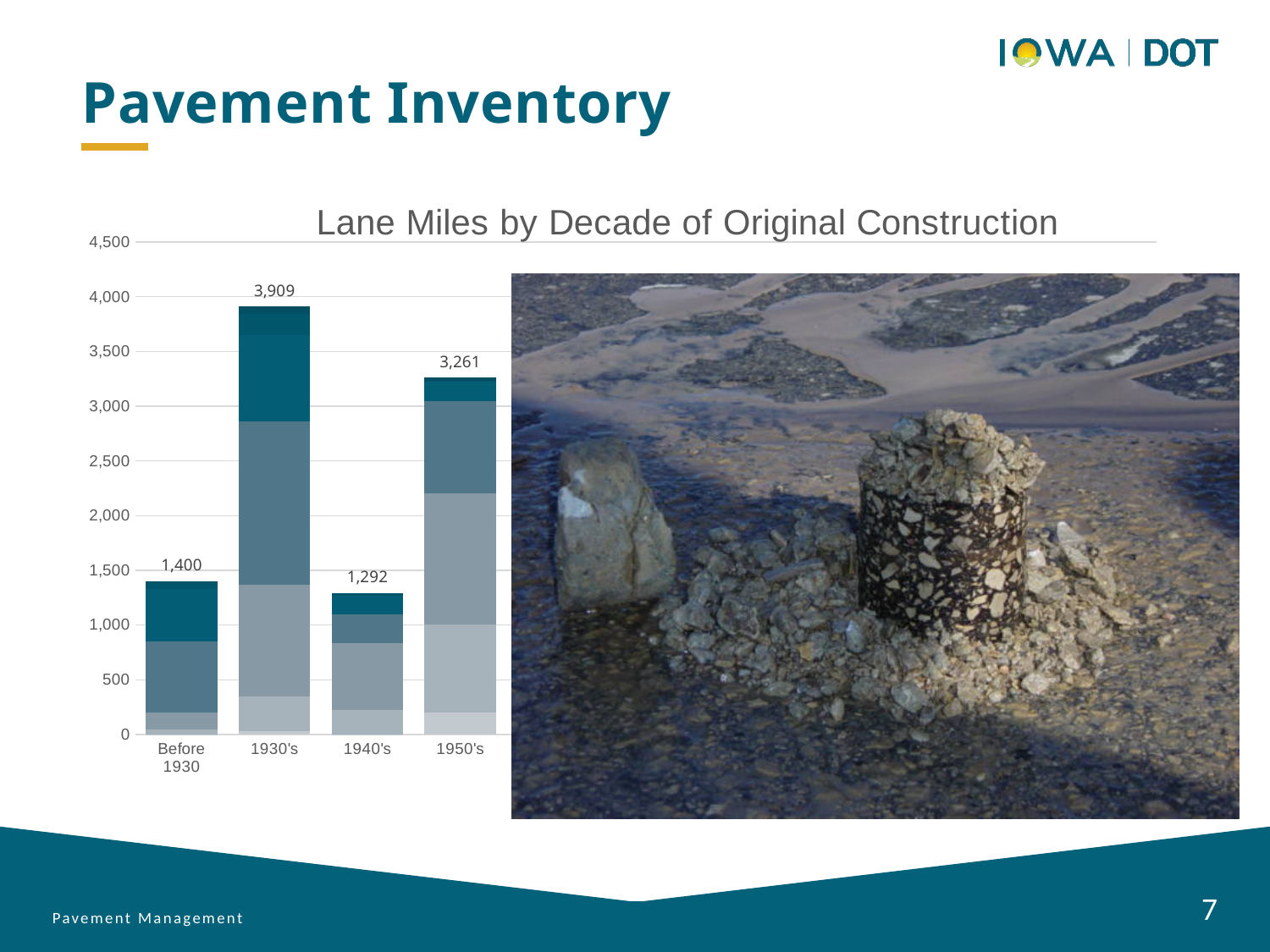
What kind of chart is shown on the slide? Stacked bar chart What is the title of the chart? Lane Miles by Decade of Original Construction What is the total lane miles value labeled for the 1930's bar? 3,909 What is the total lane miles value labeled for the 1950's bar? 3,261 Which decade has the lowest total lane miles among the bars shown? 1940's What is the difference between the total lane miles for 'Before 1930' and the 1940's? 108 Which decade has the highest total lane miles among the bars shown? 1930's Is the bottom segment of the 1930's bar greater or less than 500? less What is the total lane miles value labeled for the 'Before 1930' bar? 1,400 Which has more total lane miles, the 1950's or 'Before 1930'? 1950's What is the total lane miles value labeled for the 1940's bar? 1,292 What is the difference between the total lane miles for the 1930's and the 1950's? 648